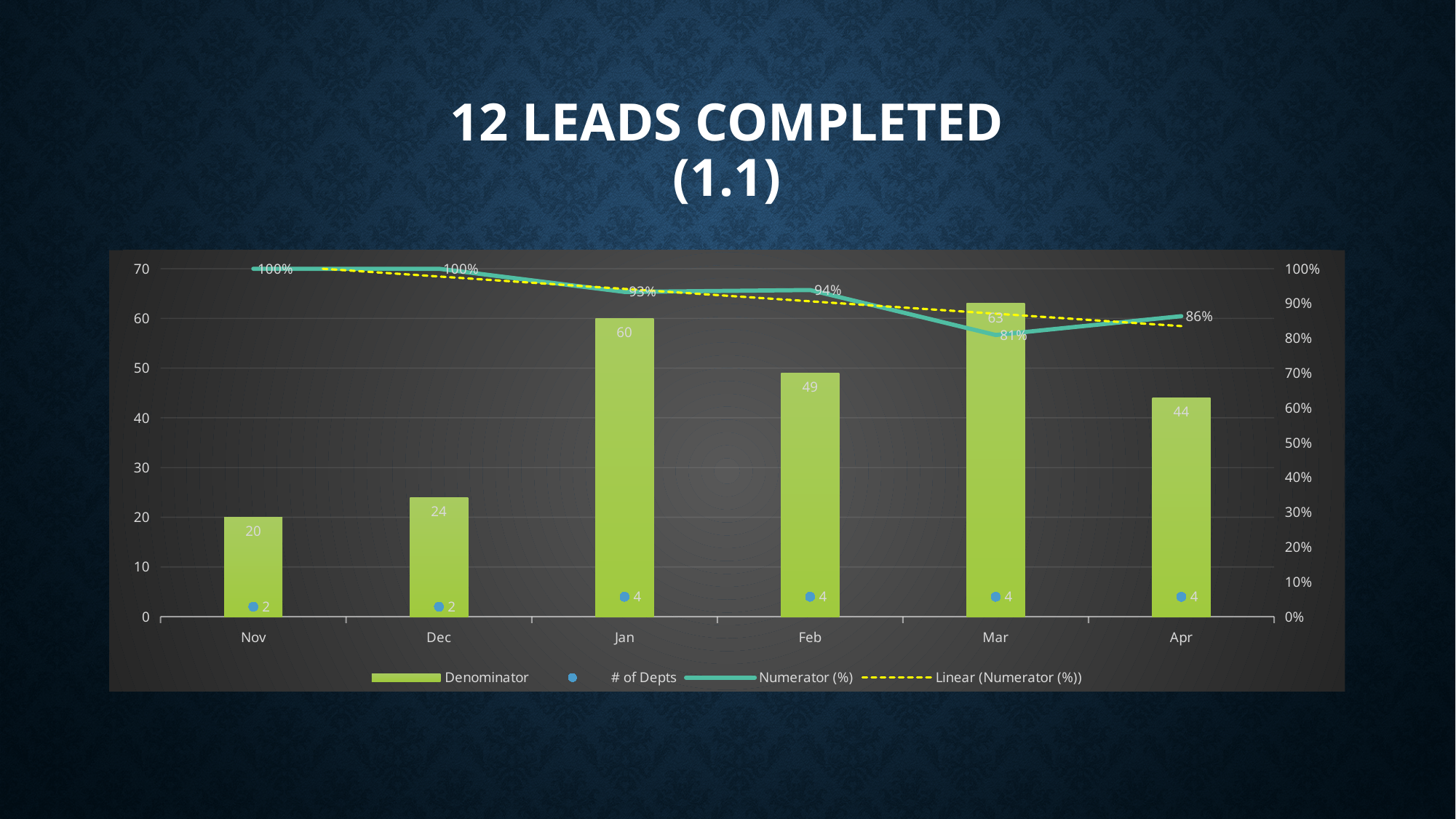
What is the title of the slide? 12 LEADS COMPLETED (1.1) How many series does the legend list? 4 What is the Denominator value for Jan? 60 Which is larger, the Denominator value for Feb or for Apr? Feb Which month has the lowest Denominator value? Nov What is the difference between the Denominator values for Mar and Apr? 19 How many months are shown on the x axis? 6 What is the Numerator (%) value for Mar? 81% Which month has the lowest Numerator (%) value? Mar What is the Numerator (%) value for Apr? 86% What is the # of Depts value for Nov? 2 Which month has the highest Denominator value? Mar